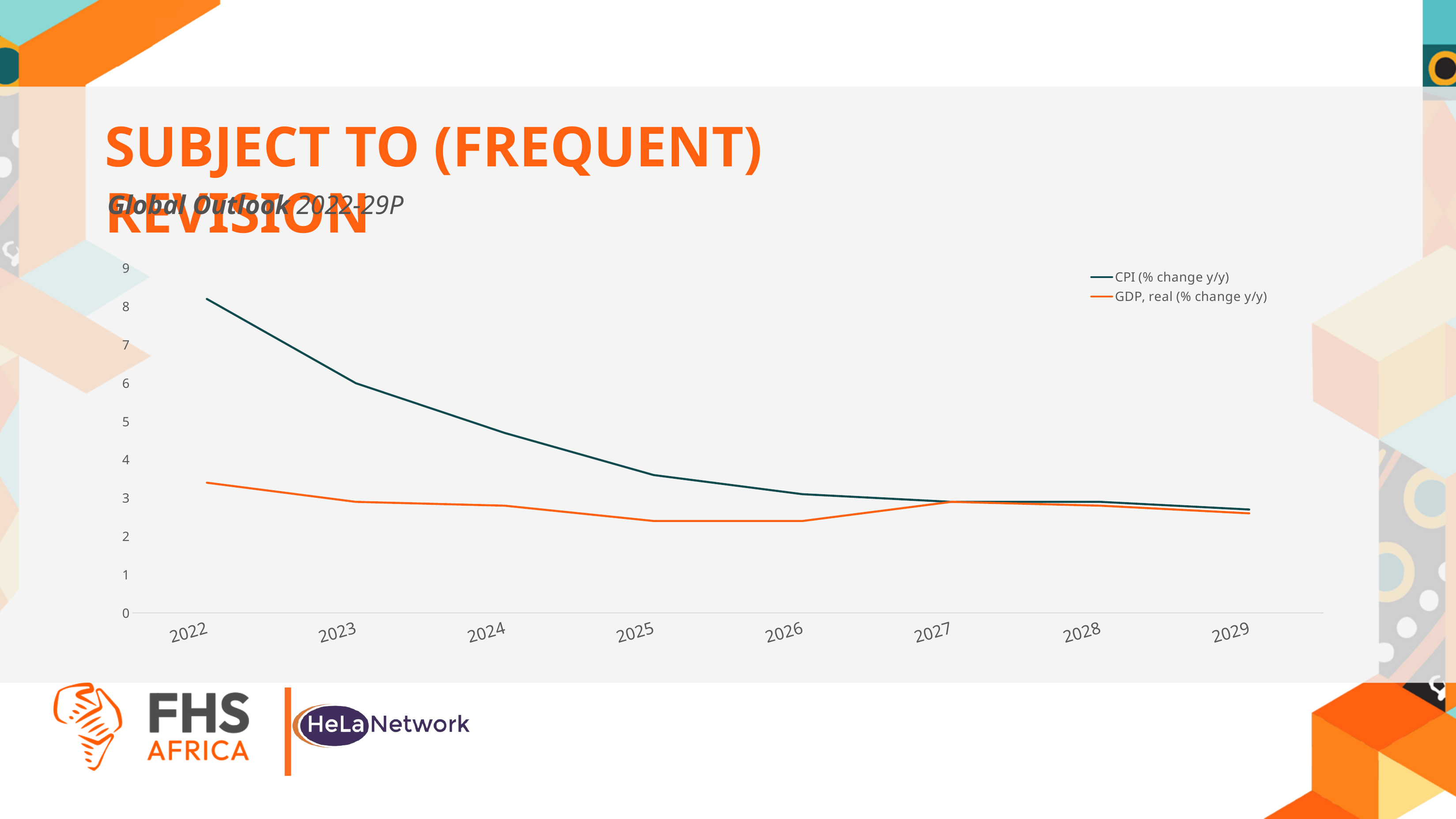
How many years are plotted along the x axis? 8 Which series is drawn in orange? GDP, real (% change y/y) In which year is GDP, real (% change y/y) highest? 2022 Does the CPI (% change y/y) line rise or fall from 2022 to 2029? fall In which year is CPI (% change y/y) highest? 2022 Is the value for CPI (% change y/y) in 2025 greater or less than 4? less Is the value for GDP, real (% change y/y) in 2025 greater or less than 3? less What kind of chart is shown on the slide? line chart In which year is CPI (% change y/y) lowest? 2029 In 2024, which is larger: CPI (% change y/y) or GDP, real (% change y/y)? CPI (% change y/y) Is the value for CPI (% change y/y) in 2022 greater or less than 7? greater How many series does the legend list? 2